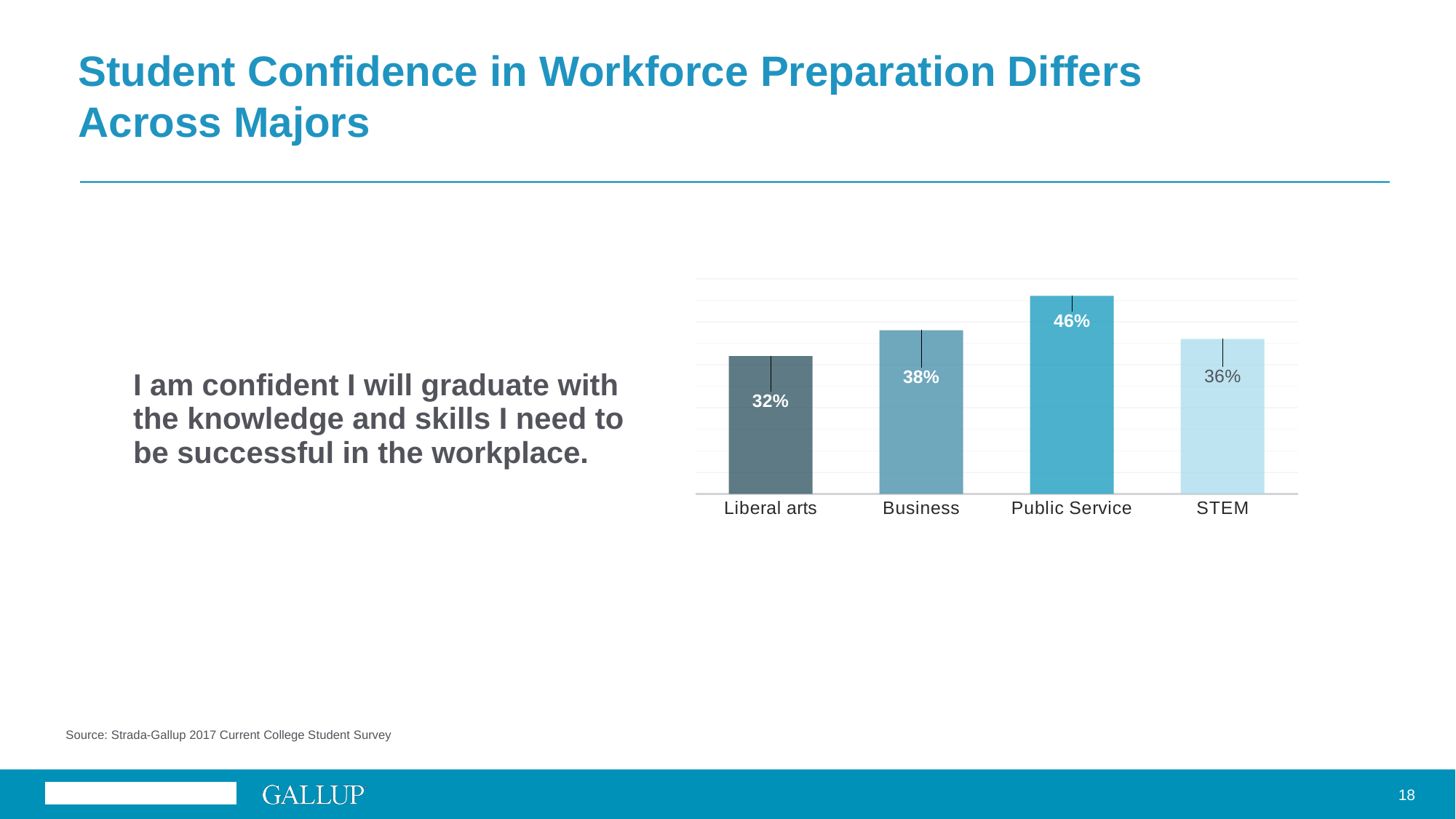
What is the value shown for Public Service majors? 46% What is the difference in percentage points between Business and STEM? 2 percentage points What type of chart is used on the slide? Bar chart What is the value shown for STEM majors? 36% What percentage of Liberal arts students are confident they will graduate with the knowledge and skills needed for the workplace? 32% What survey is cited as the source of the chart data? Strada-Gallup 2017 Current College Student Survey What is the value shown for Business majors? 38% Which major has the highest share of students confident in their workforce preparation? Public Service What is the difference in percentage points between Public Service and Liberal arts? 14 percentage points Which is larger, the value for Business or the value for STEM? Business Which major has the lowest share of students confident in their workforce preparation? Liberal arts How many majors are shown in the chart? 4